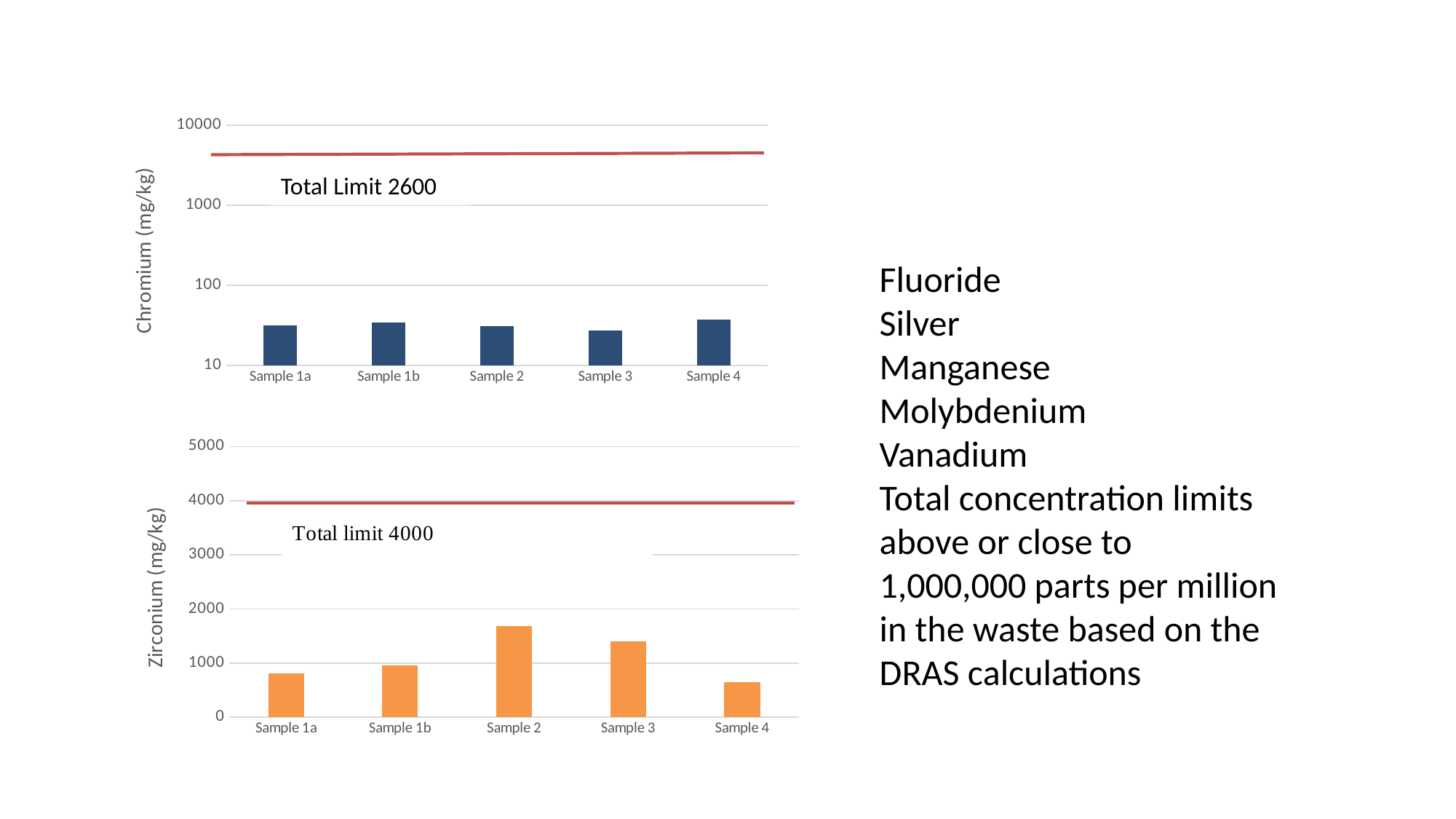
In the Zirconium chart, which sample has the lowest value? Sample 4 What total limit is labelled on the Zirconium chart? Total limit 4000 In the Chromium chart, how many samples are plotted? 5 In the Zirconium chart, which sample has the highest value? Sample 2 In the Chromium chart, is the value for Sample 3 greater or less than 10? greater What kind of chart is the Zirconium chart? bar chart In the Zirconium chart, which is larger, Sample 2 or Sample 3? Sample 2 In the Zirconium chart, is the value for Sample 4 greater or less than 1000? less In the Chromium chart, is the value for Sample 4 greater or less than 100? less What is the y-axis label of the top chart? Chromium (mg/kg)